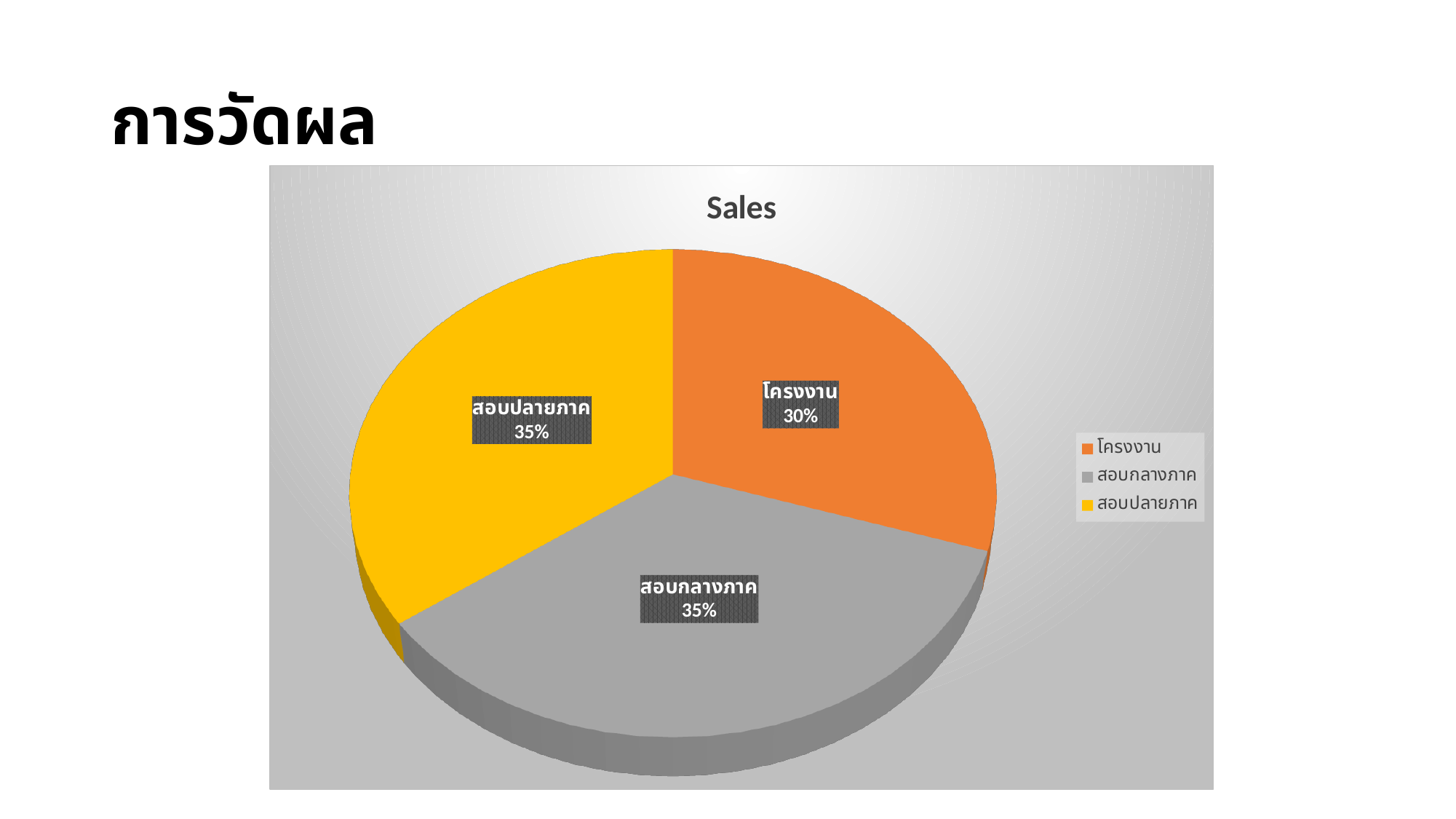
Which category has the smallest slice of the pie? โครงงาน What share of the pie does โครงงาน represent? 30% What colour is the slice for โครงงาน? Orange How many entries does the legend list? 3 What is the title of the chart? Sales What share of the pie does สอบกลางภาค represent? 35% Which is larger, the slice for สอบปลายภาค or the slice for โครงงาน? สอบปลายภาค What kind of chart is shown on the slide? Pie chart What is the difference in percentage points between สอบกลางภาค and โครงงาน? 5% How many slices does the pie chart have? 3 Is the share for โครงงาน greater or less than 35%? less What share of the pie does สอบปลายภาค represent? 35%